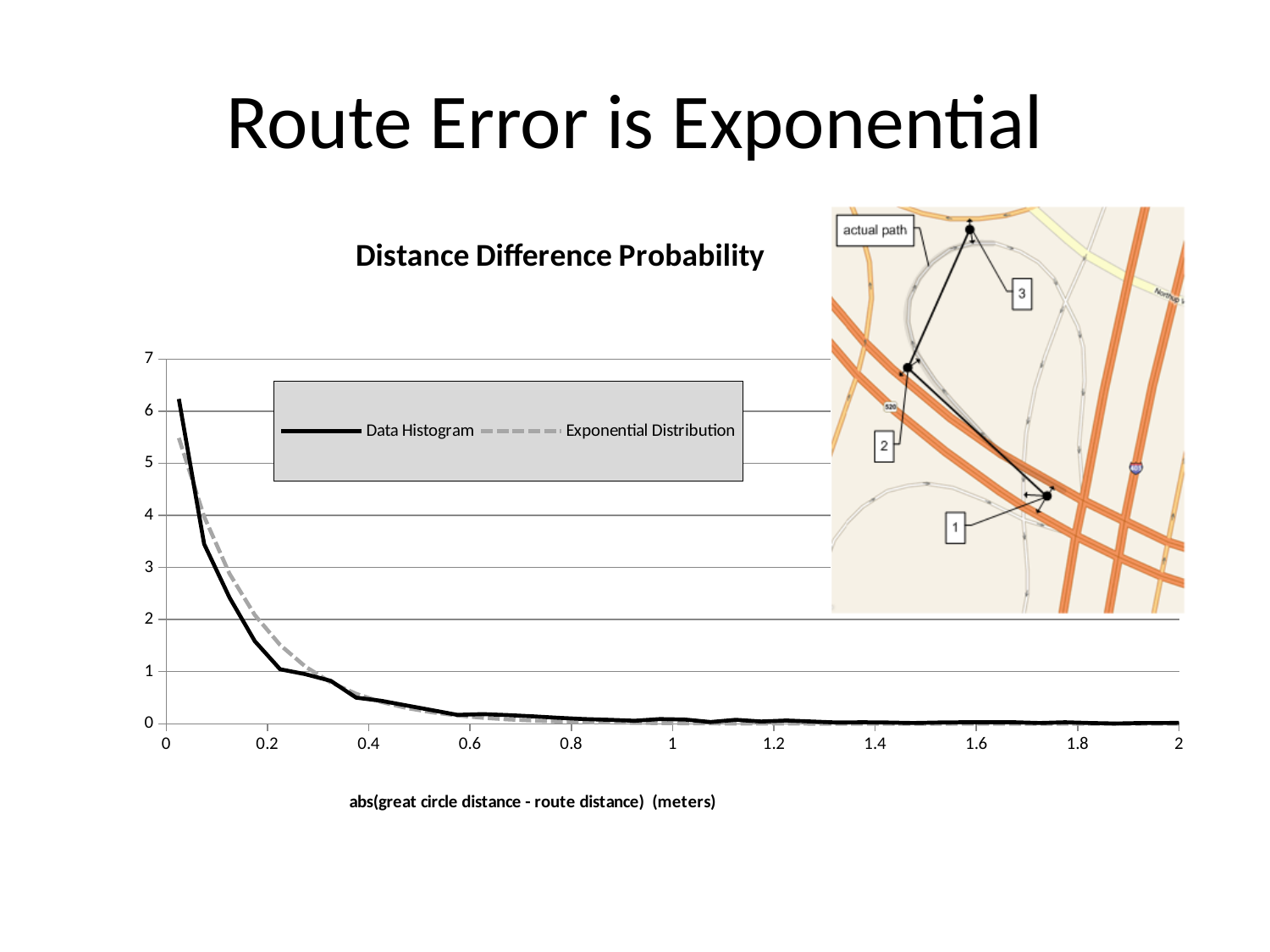
Is the value of the Exponential Distribution series at its leftmost point greater or less than 4? greater Which series is drawn with a dashed line in the "Distance Difference Probability" chart? Exponential Distribution How many series does the legend of the "Distance Difference Probability" chart list? 2 Do the values of the Exponential Distribution series rise or fall as the x axis increases? fall What are the two series named in the legend of the "Distance Difference Probability" chart? Data Histogram and Exponential Distribution What kind of chart is the "Distance Difference Probability" chart? line chart Is the value of the Data Histogram series at x = 0.4 greater or less than 1? less Is the value of the Data Histogram series at its leftmost point greater or less than 5? greater Do the values of the Data Histogram series rise or fall as the x axis increases? fall What is the x-axis label of the "Distance Difference Probability" chart? abs(great circle distance - route distance) (meters) At x = 0.2, which series has the larger value, Data Histogram or Exponential Distribution? Exponential Distribution